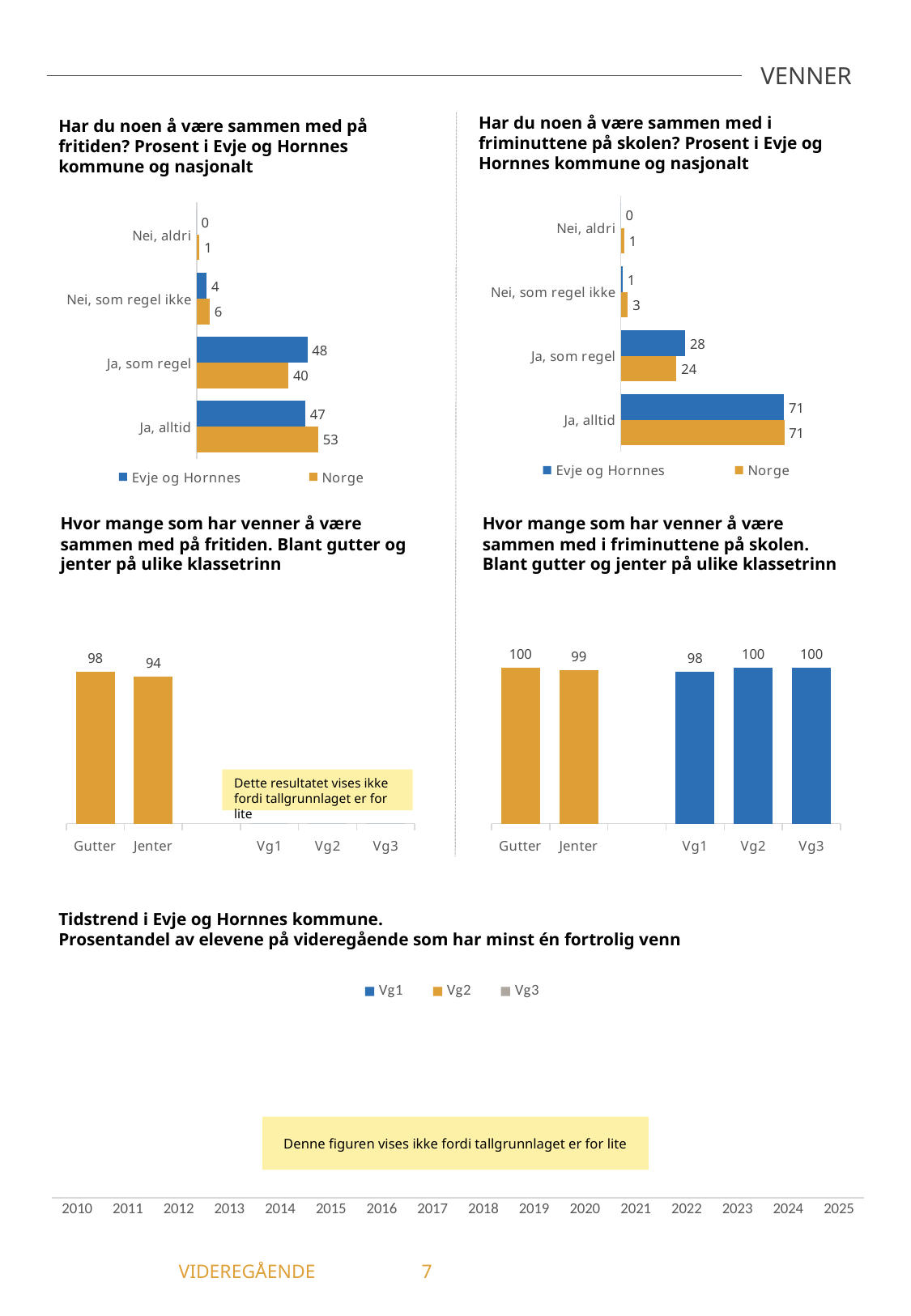
In the chart 'Hvor mange som har venner å være sammen med på fritiden', what is the difference between Gutter and Jenter? 4 In the chart 'Har du noen å være sammen med på fritiden?', what is the difference between Evje og Hornnes and Norge for 'Ja, som regel'? 8 In the chart 'Har du noen å være sammen med på fritiden?', which series has the larger value for 'Nei, som regel ikke'? Norge How many series does the legend list in the chart 'Har du noen å være sammen med i friminuttene på skolen?'? 2 In the chart 'Har du noen å være sammen med på fritiden?', what is the value for Norge in the category 'Ja, alltid'? 53 In the chart 'Hvor mange som har venner å være sammen med i friminuttene på skolen', what is the value for Vg1? 98 In the chart 'Har du noen å være sammen med i friminuttene på skolen?', what is the value for Evje og Hornnes in the category 'Ja, som regel'? 28 In the chart 'Har du noen å være sammen med i friminuttene på skolen?', what is the value for Norge in the category 'Ja, alltid'? 71 In the chart 'Har du noen å være sammen med i friminuttene på skolen?', which category has the highest value for Evje og Hornnes? Ja, alltid In the chart 'Har du noen å være sammen med på fritiden?', what is the value for Evje og Hornnes in the category 'Ja, som regel'? 48 In the chart 'Hvor mange som har venner å være sammen med på fritiden', what is the value for Jenter? 94 What kind of chart is 'Har du noen å være sammen med på fritiden?'? Bar chart